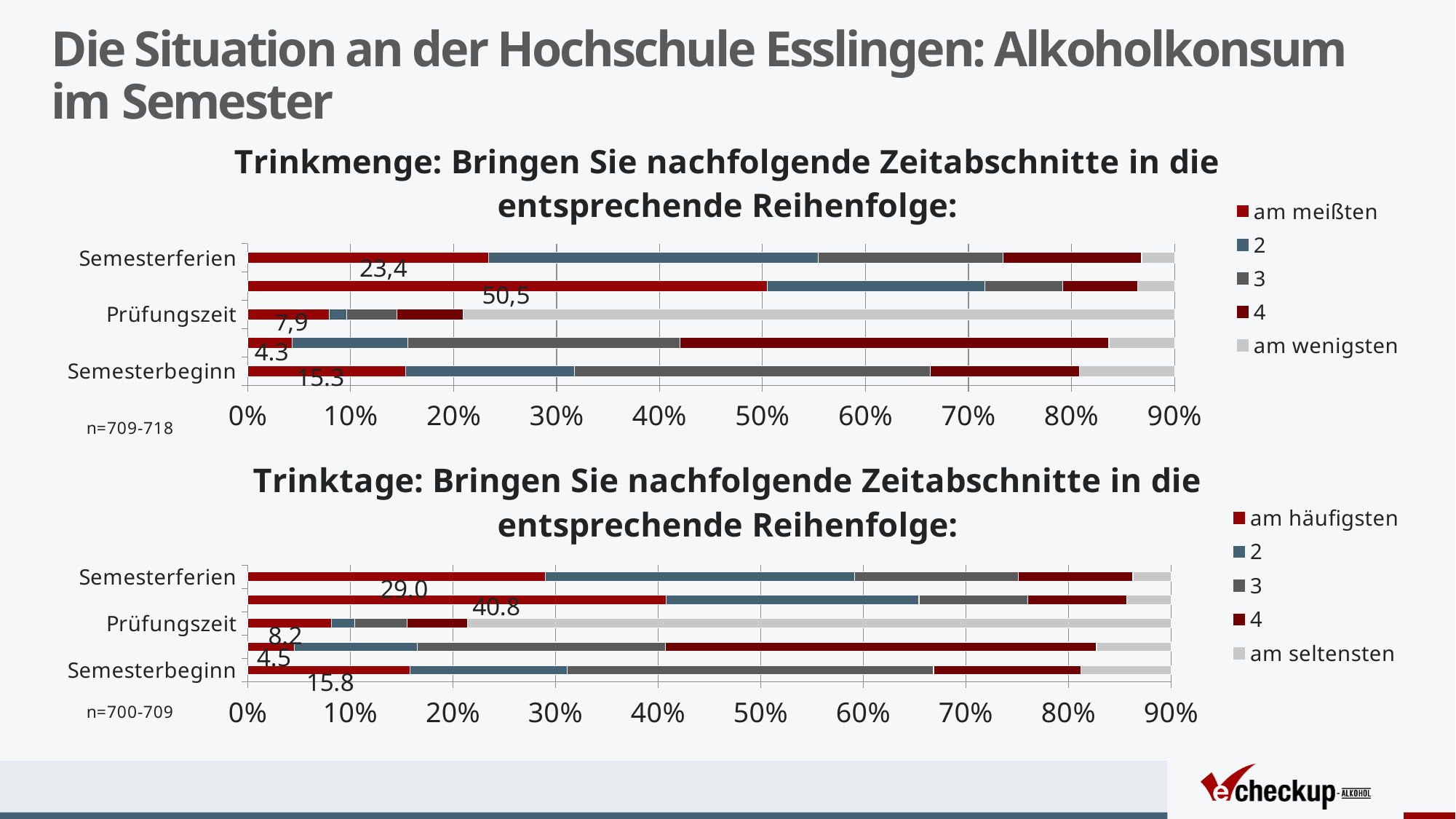
In the bottom chart (Trinktage), what is the value of the 'am häufigsten' segment for Semesterbeginn? 15.8 In the top chart (Trinkmenge), what is the value of the 'am meißten' segment for Prüfungszeit? 7,9 In the top chart (Trinkmenge), what is the value of the 'am meißten' segment for Semesterferien? 23,4 In the bottom chart (Trinktage), what is the difference between the 'am häufigsten' values for Semesterferien and Prüfungszeit? 20.8 What kind of chart is the bottom chart (Trinktage)? Stacked bar chart In the top chart (Trinkmenge), what is the difference between the 'am meißten' values for Semesterferien and Prüfungszeit? 15,5 In the bottom chart (Trinktage), which has the larger 'am häufigsten' value, Semesterbeginn or Prüfungszeit? Semesterbeginn What is the last legend entry of the bottom chart (Trinktage)? am seltensten In the top chart (Trinkmenge), is the 'am meißten' value for Semesterferien greater or less than 20%? greater In the top chart (Trinkmenge), what is the value of the 'am meißten' segment for Semesterbeginn? 15.3 In the bottom chart (Trinktage), what is the value of the 'am häufigsten' segment for Semesterferien? 29.0 How many series does the legend of the top chart (Trinkmenge) list? 5